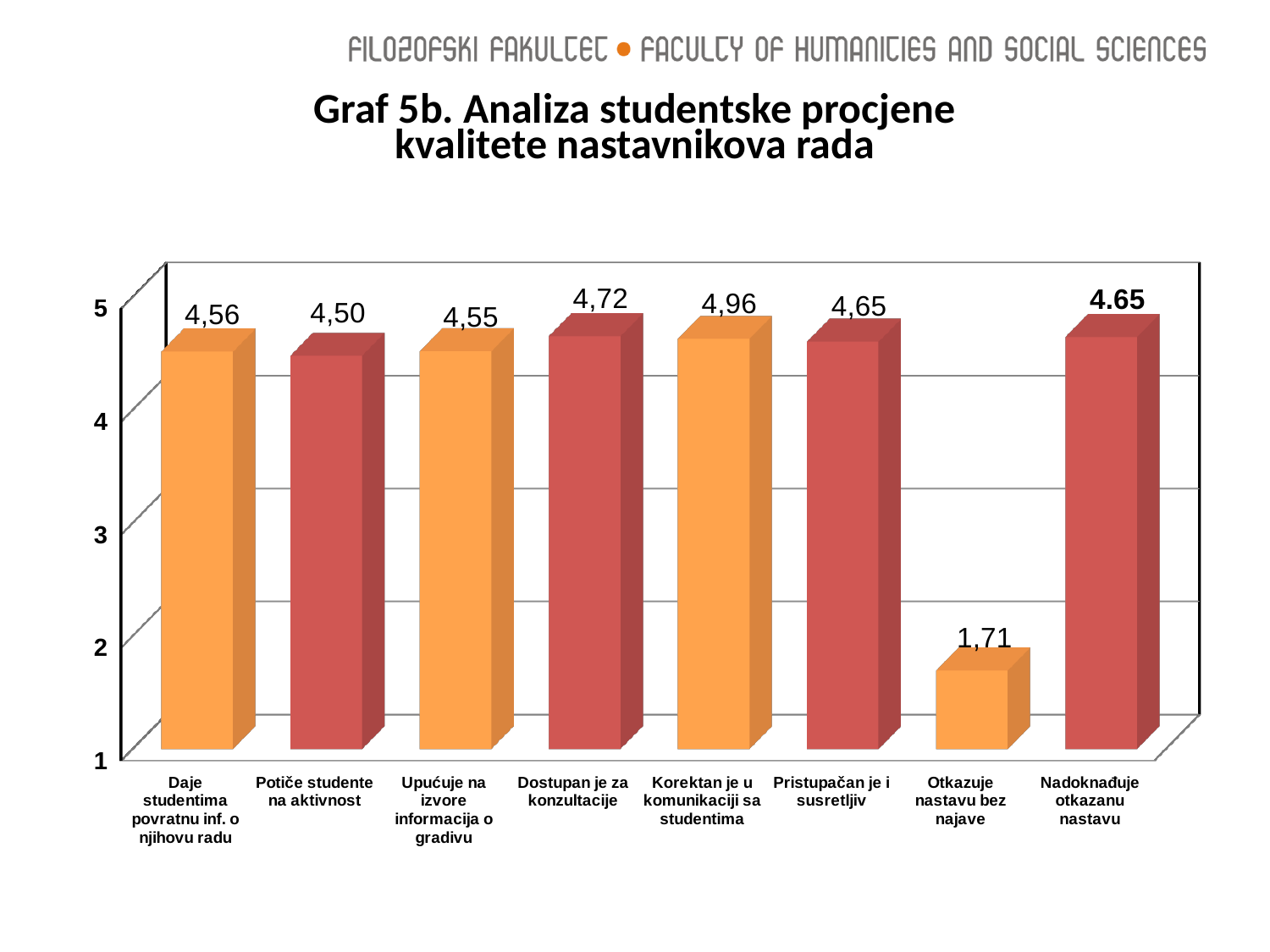
What is the value for "Korektan je u komunikaciji sa studentima"? 4,96 Which category has the highest value? Korektan je u komunikaciji sa studentima What kind of chart is shown on the slide? bar chart Which category has the lowest value? Otkazuje nastavu bez najave What is the difference between the values for "Korektan je u komunikaciji sa studentima" and "Otkazuje nastavu bez najave"? 3,25 What is the value for "Dostupan je za konzultacije"? 4,72 Which is larger, the value for "Dostupan je za konzultacije" or the value for "Daje studentima povratnu inf. o njihovu radu"? Dostupan je za konzultacije Is the value for "Otkazuje nastavu bez najave" greater or less than 2? less What is the value for "Potiče studente na aktivnost"? 4,50 What is the title of the chart? Graf 5b. Analiza studentske procjene kvalitete nastavnikova rada What is the value for "Otkazuje nastavu bez najave"? 1,71 How many categories are shown on the x axis? 8